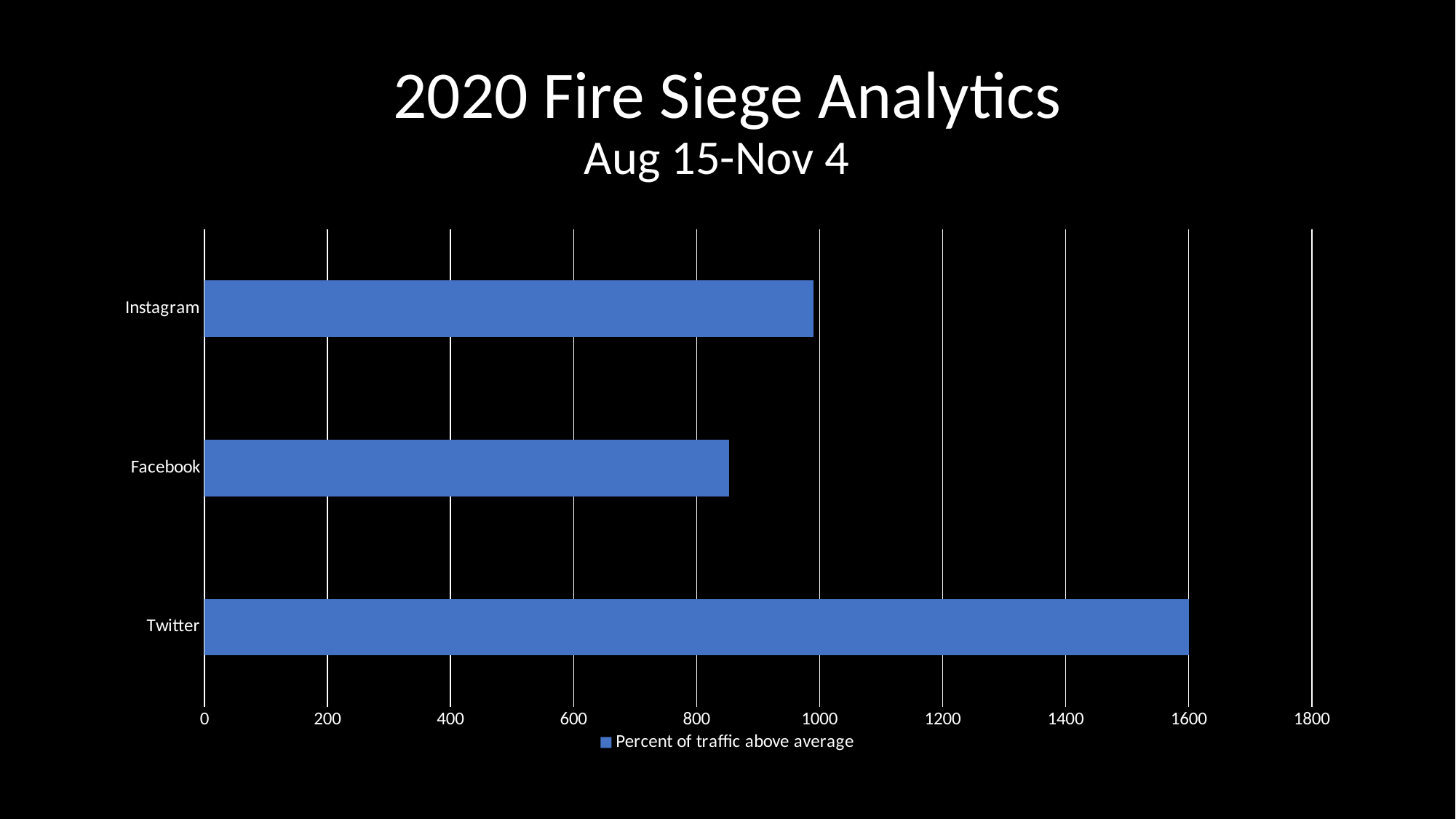
Which category has the lowest percent of traffic above average? Facebook Which category has the highest percent of traffic above average? Twitter Which is larger, the value for Twitter or the value for Instagram? Twitter How many categories are plotted in the chart? 3 Which is larger, the value for Instagram or the value for Facebook? Instagram What kind of chart is shown on the slide? bar chart How many series does the legend list? 1 What is the percent of traffic above average for Twitter? 1600 Is the value for Facebook greater or less than 800? greater What series name does the legend show? Percent of traffic above average What is the title of the chart? 2020 Fire Siege Analytics Is the value for Instagram greater or less than 1200? less